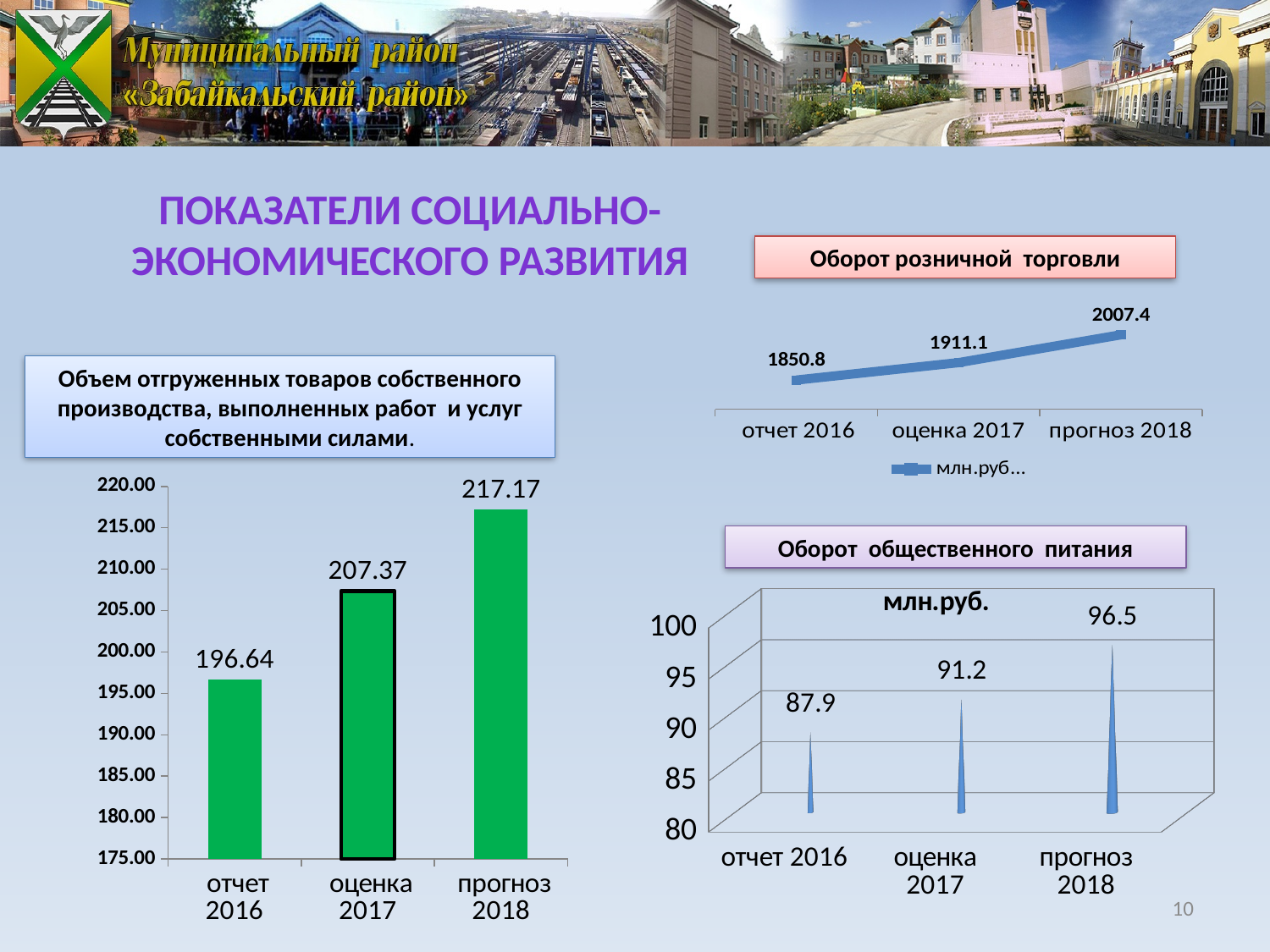
In the chart 'Оборот розничной торговли', what is the value for прогноз 2018? 2007.4 In the chart 'Оборот розничной торговли', what is the difference between прогноз 2018 and отчет 2016? 156.6 In the chart 'Оборот общественного питания', what is the difference between прогноз 2018 and оценка 2017? 5.3 In the chart 'Объем отгруженных товаров собственного производства, выполненных работ и услуг собственными силами', what is the value for оценка 2017? 207.37 In the chart 'Объем отгруженных товаров собственного производства, выполненных работ и услуг собственными силами', which category has the lowest value? отчет 2016 In the chart 'Оборот розничной торговли', do the values rise or fall from отчет 2016 to прогноз 2018? rise In the chart 'Оборот общественного питания', which category has the highest value? прогноз 2018 In the chart 'Объем отгруженных товаров собственного производства, выполненных работ и услуг собственными силами', what is the difference between прогноз 2018 and отчет 2016? 20.53 How many categories are shown in the chart 'Оборот общественного питания'? 3 What kind of chart is 'Оборот розничной торговли'? line chart What kind of chart is 'Объем отгруженных товаров собственного производства, выполненных работ и услуг собственными силами'? bar chart In the chart 'Оборот общественного питания', what is the value for отчет 2016? 87.9